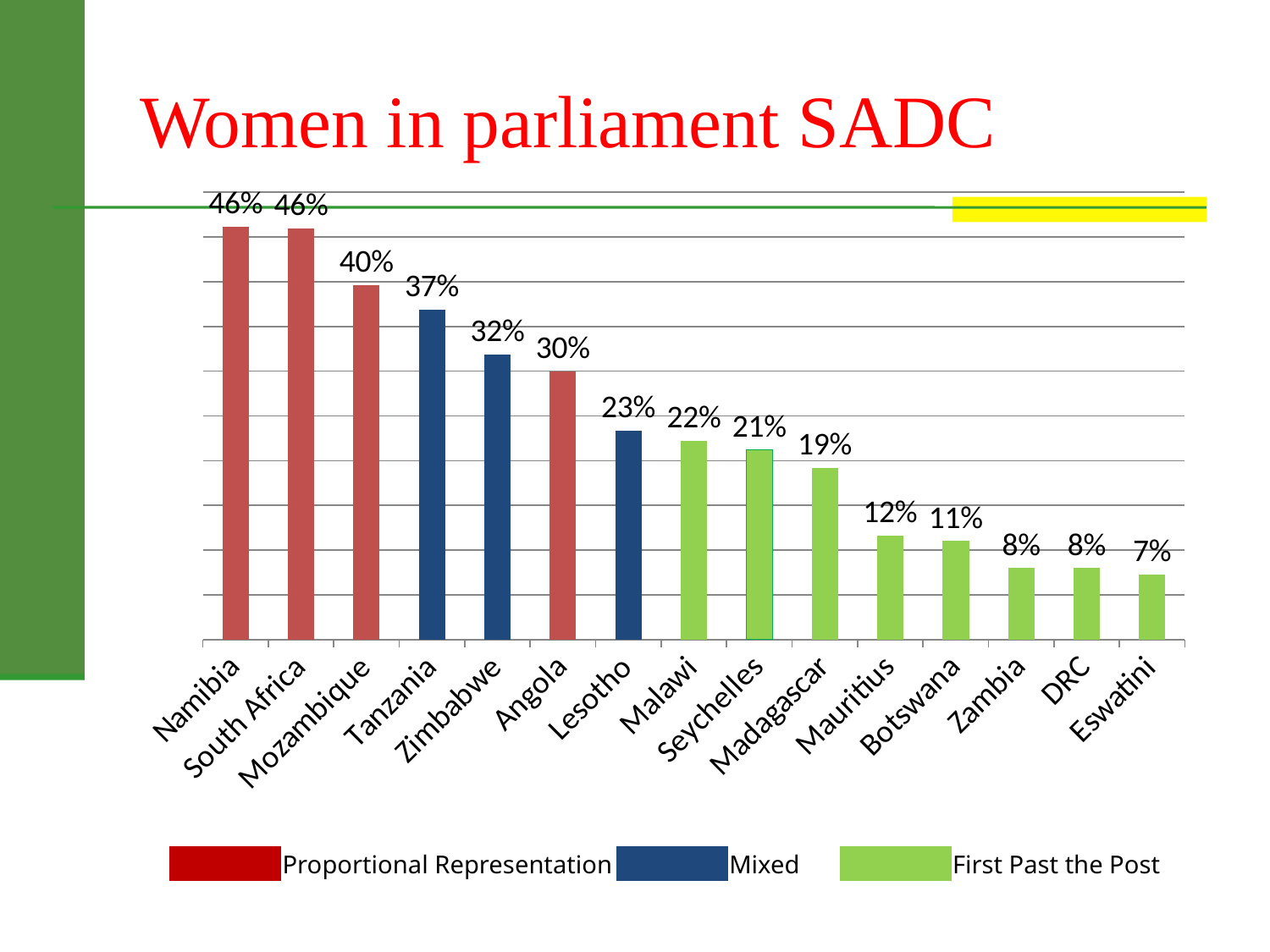
What kind of chart is shown on the slide? Bar chart How many entries does the legend list? 3 Which country has the lowest value? Eswatini According to the legend, which electoral system do the green bars represent? First Past the Post How many countries are shown on the chart? 15 What is the title of the slide? Women in parliament SADC What is the value for Mozambique? 40% Which has a larger value, Zimbabwe or Angola? Zimbabwe What is the difference between the values for Mozambique and Tanzania? 3% What is the value for Lesotho? 23% What is the value for Madagascar? 19% Do the values rise or fall from left to right along the x axis? Fall